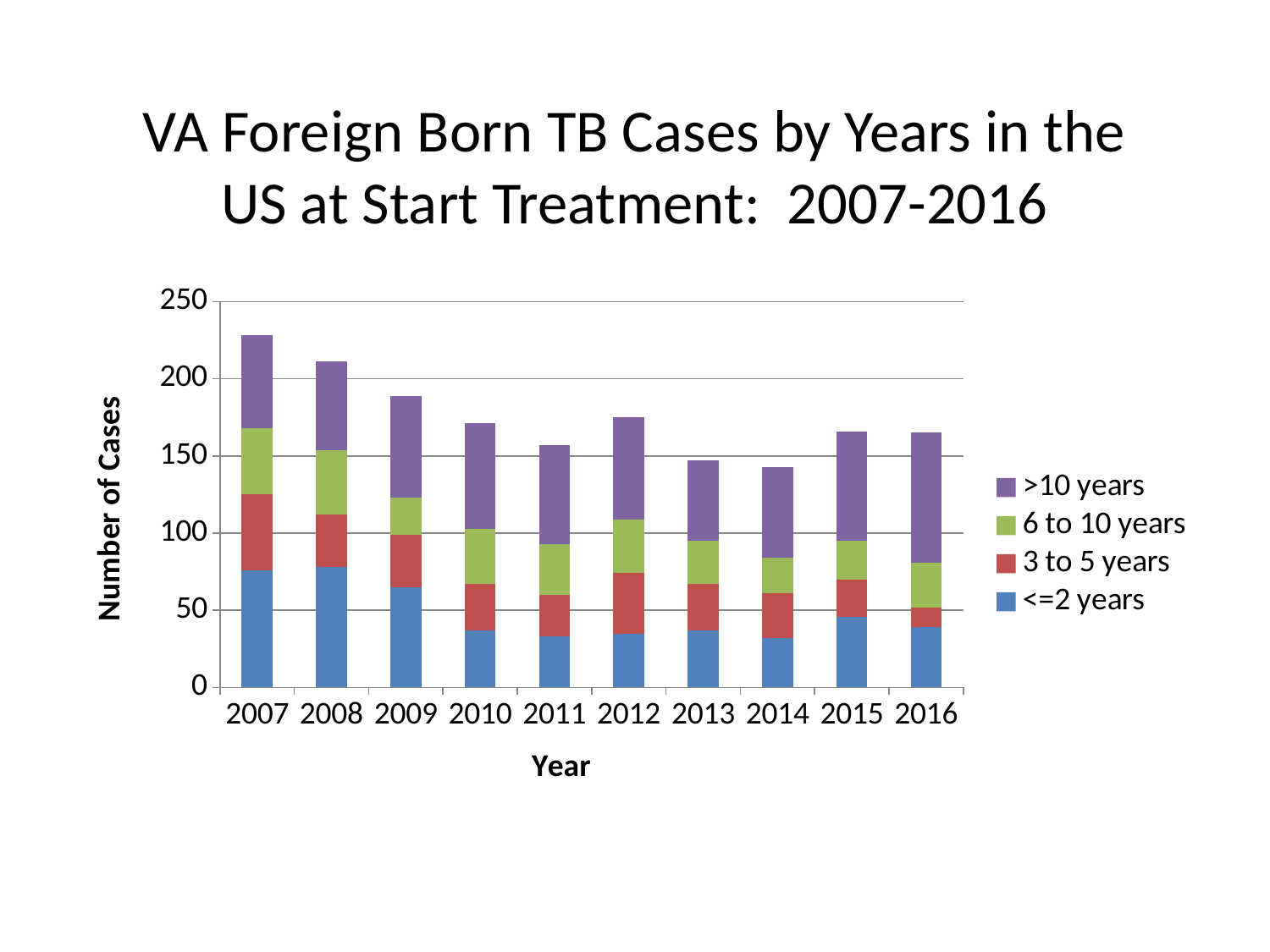
What is the label of the y axis? Number of Cases What kind of chart is shown on the slide? stacked bar chart Is the total number of cases in 2007 greater or less than 200? greater Is the total number of cases in 2016 greater or less than 150? greater Is the total number of cases in 2009 greater or less than 200? less Do the total number of cases generally rise or fall from 2007 to 2014? fall Which year has the highest total number of cases? 2007 How many series does the legend list? 4 Which year has a larger total number of cases, 2007 or 2016? 2007 How many years are shown along the x axis? 10